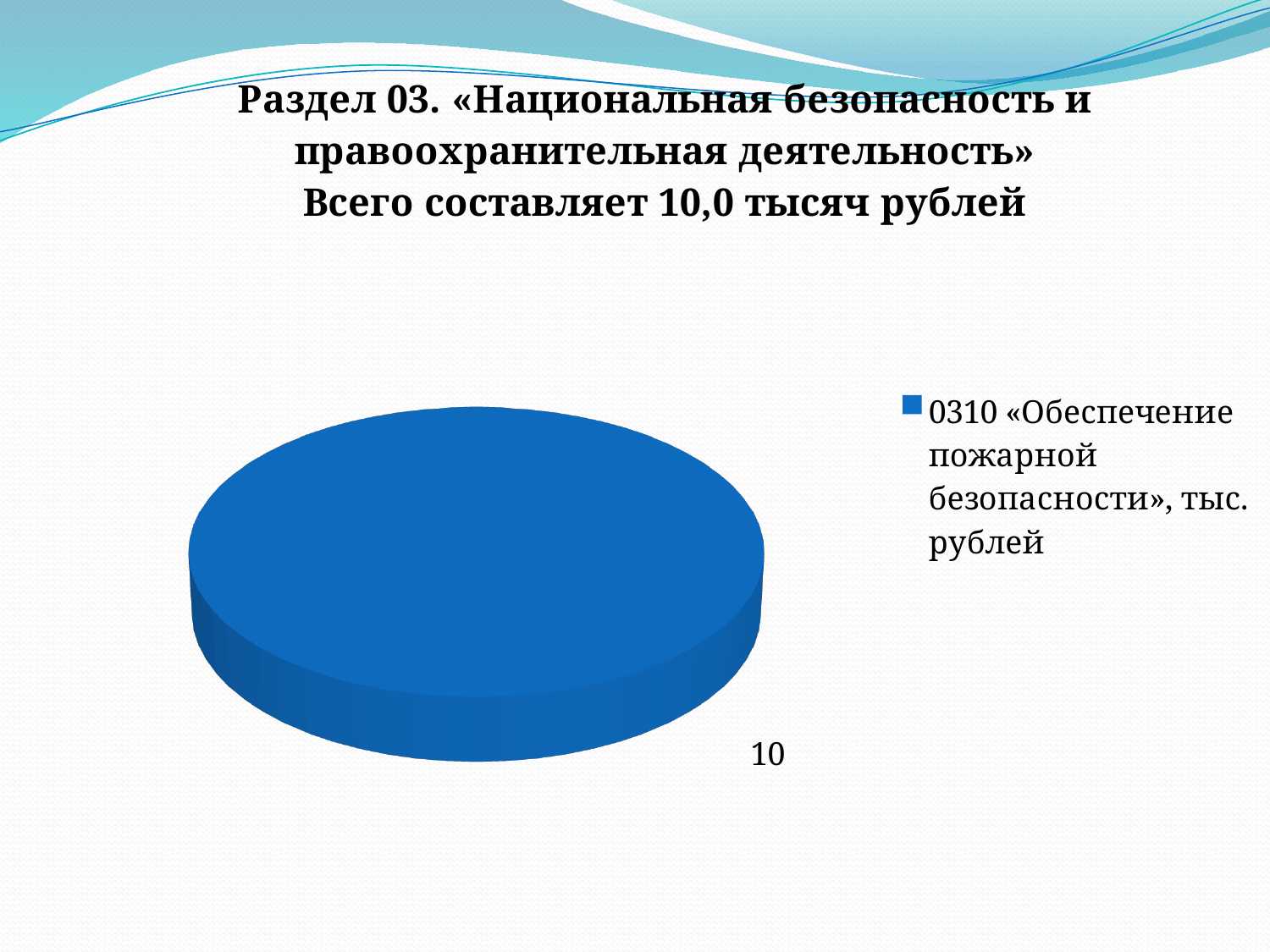
What kind of chart is shown on the slide? pie chart What is the value for «0310 «Обеспечение пожарной безопасности», тыс. рублей» in the pie chart? 10 What value is printed as the data label on the pie chart? 10 What is the legend entry shown next to the pie chart? 0310 «Обеспечение пожарной безопасности», тыс. рублей How many entries does the legend list? 1 What share of the pie does the slice «0310 «Обеспечение пожарной безопасности»» represent? 100% What colour is the single slice of the pie chart? blue How many slices does the pie chart have? 1